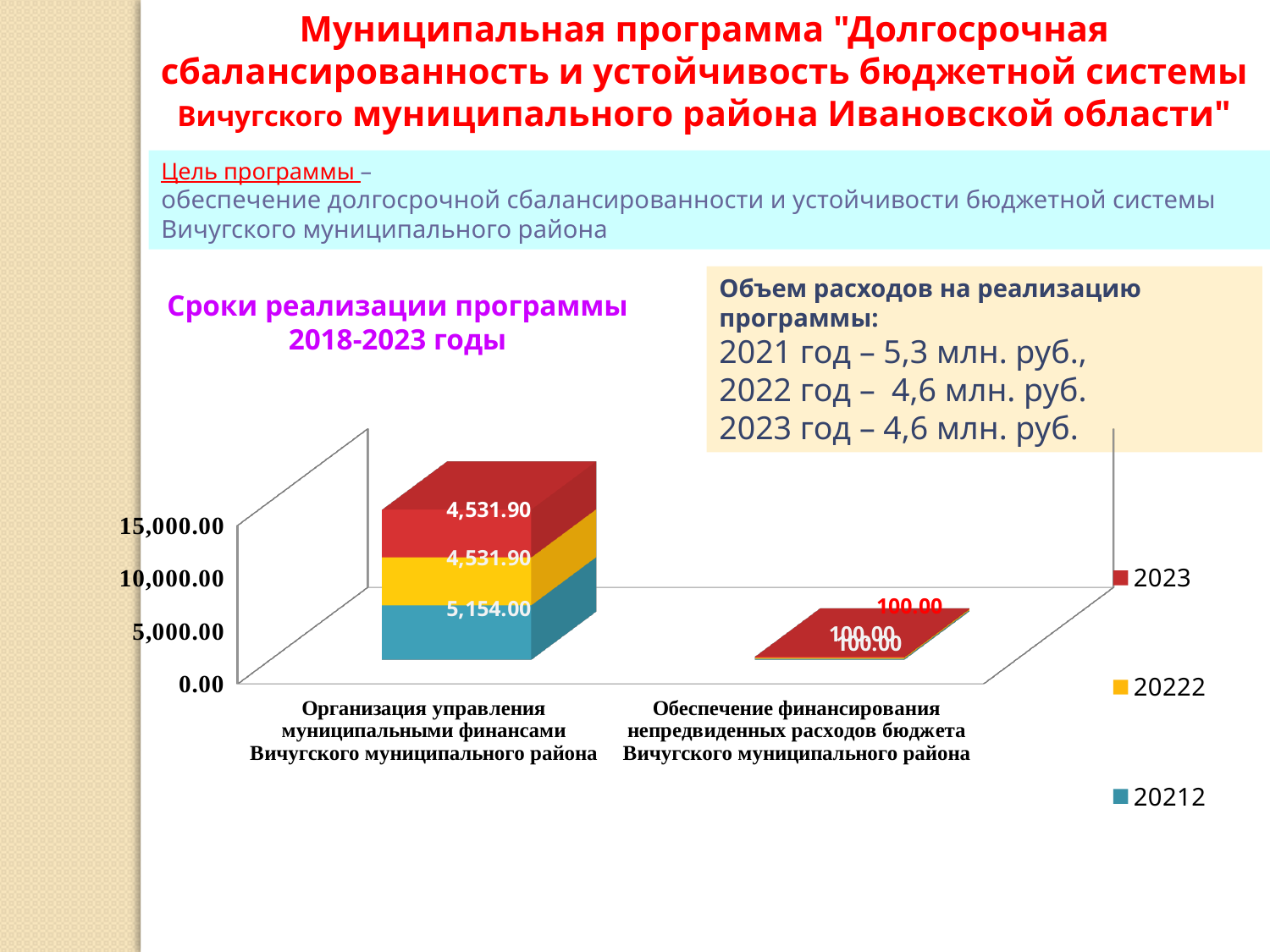
What is the value of the blue (bottom) segment for "Организация управления муниципальными финансами Вичугского муниципального района"? 5,154.00 What is the total of the stacked bar for "Организация управления муниципальными финансами Вичугского муниципального района"? 14,217.80 What colour is the series labelled 2023 in the legend? red Is the total of the bar for "Организация управления муниципальными финансами Вичугского муниципального района" greater or less than 10,000.00? greater How many series does the chart legend list? 3 How many categories are shown on the x axis of the chart? 2 What is the difference between the blue segment (5,154.00) and the red segment (4,531.90) in the bar for "Организация управления муниципальными финансами Вичугского муниципального района"? 622.10 What is the value of the red (top, 2023) segment for "Организация управления муниципальными финансами Вичугского муниципального района"? 4,531.90 What is the value of the yellow (middle) segment for "Организация управления муниципальными финансами Вичугского муниципального района"? 4,531.90 What kind of chart is shown on the slide? stacked bar chart What is the value of the 2023 segment for "Обеспечение финансирования непредвиденных расходов бюджета Вичугского муниципального района"? 100.00 Which category has the taller stacked bar? Организация управления муниципальными финансами Вичугского муниципального района